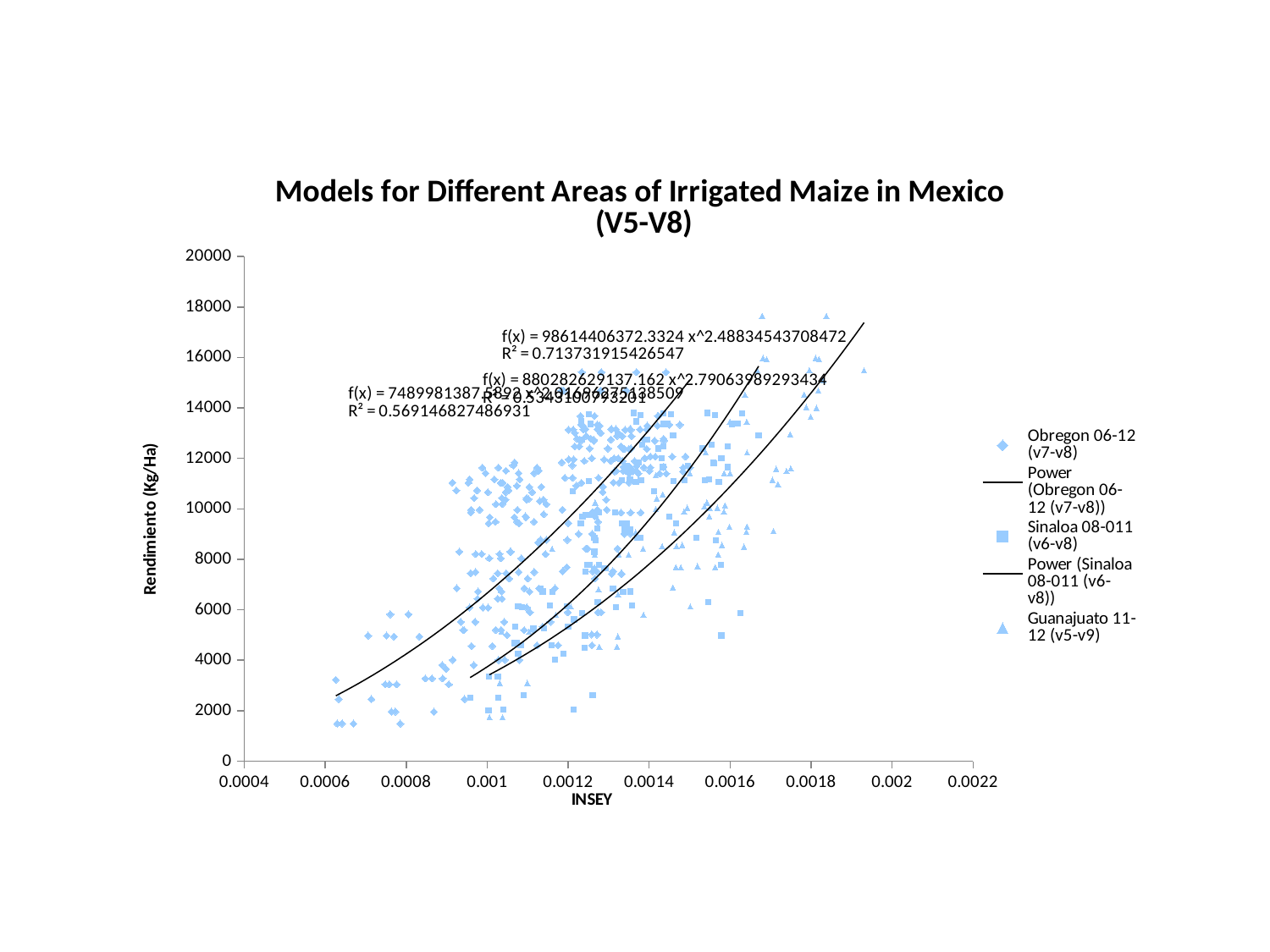
What is the label of the x axis? INSEY Do the yields generally rise or fall as INSEY increases along the x axis? Rise What is the maximum value shown on the y axis? 20000 What kind of chart is shown on the slide? Scatter chart What is the label of the y axis? Rendimiento (Kg/Ha) Is the lowest Obregon 06-12 (v7-v8) point greater or less than 2000 Kg/Ha? less What is the R² value shown for the topmost trendline equation, f(x) = 98614406372.3324 x^2.48834543708472? 0.713731915426547 Is the highest Guanajuato 11-12 (v5-v9) point greater or less than 16000 Kg/Ha? greater What is the R² value shown for the trendline equation f(x) = 7489981387.5893 x^2.01...? 0.569146827486931 Which series is plotted with triangle markers? Guanajuato 11-12 (v5-v9) What is the title of the chart? Models for Different Areas of Irrigated Maize in Mexico (V5-V8) How many entries does the chart's legend list? 5